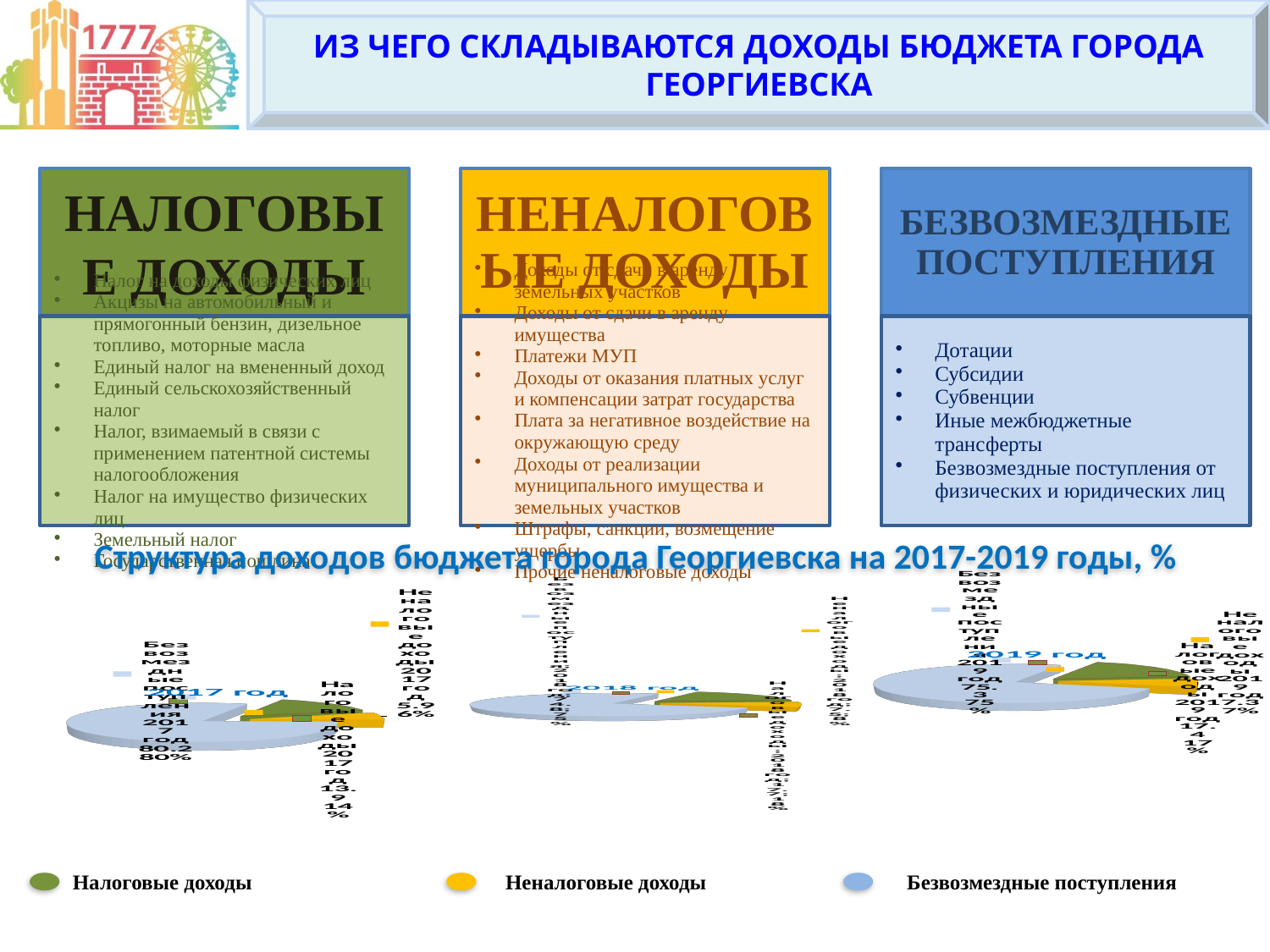
What kind of chart is used to show the structure of budget revenues for 2017-2019? pie chart In the 2019 pie chart, what percentage share is shown for Безвозмездные поступления? 75% In the 2019 pie chart, which category has the largest share? Безвозмездные поступления In the 2019 pie chart, which category has the smallest share? Неналоговые доходы What colour represents Безвозмездные поступления in the legend? light blue How many categories does the legend at the bottom of the slide list? 3 In the 2017 pie chart, which category has the largest share? Безвозмездные поступления In the 2017 pie chart, which is larger: Налоговые доходы or Неналоговые доходы? Налоговые доходы How many pie charts are shown on the slide? 3 In the 2017 pie chart, what percentage share is shown for Безвозмездные поступления? 80% In the 2017 pie chart, which category has the smallest share? Неналоговые доходы What is the title of the chart section on the slide? Структура доходов бюджета города Георгиевска на 2017-2019 годы, %